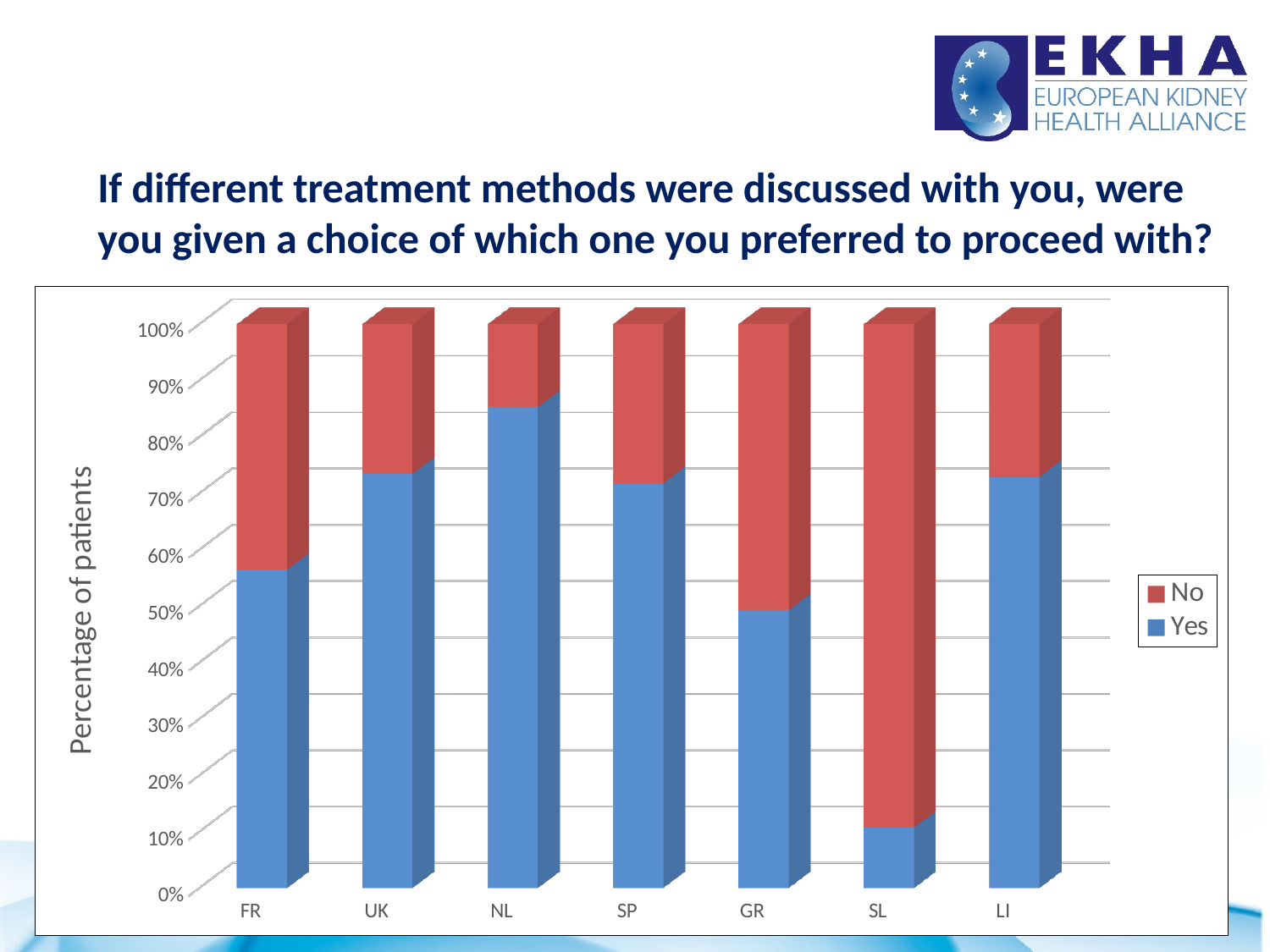
Which country has the lowest share of 'Yes' responses? SL Which has a larger 'Yes' share, NL or GR? NL What is the title of the vertical axis? Percentage of patients Is the 'Yes' value for SL greater or less than 20%? less How many countries are shown on the x axis of the chart? 7 Is the 'Yes' value for FR greater or less than 50%? greater What is the total of the stacked bar for UK? 100% Which country has the highest share of 'Yes' responses? NL Is the 'No' value for GR greater or less than 40%? greater How many series does the chart's legend list? 2 What kind of chart is shown on the slide? Stacked bar chart